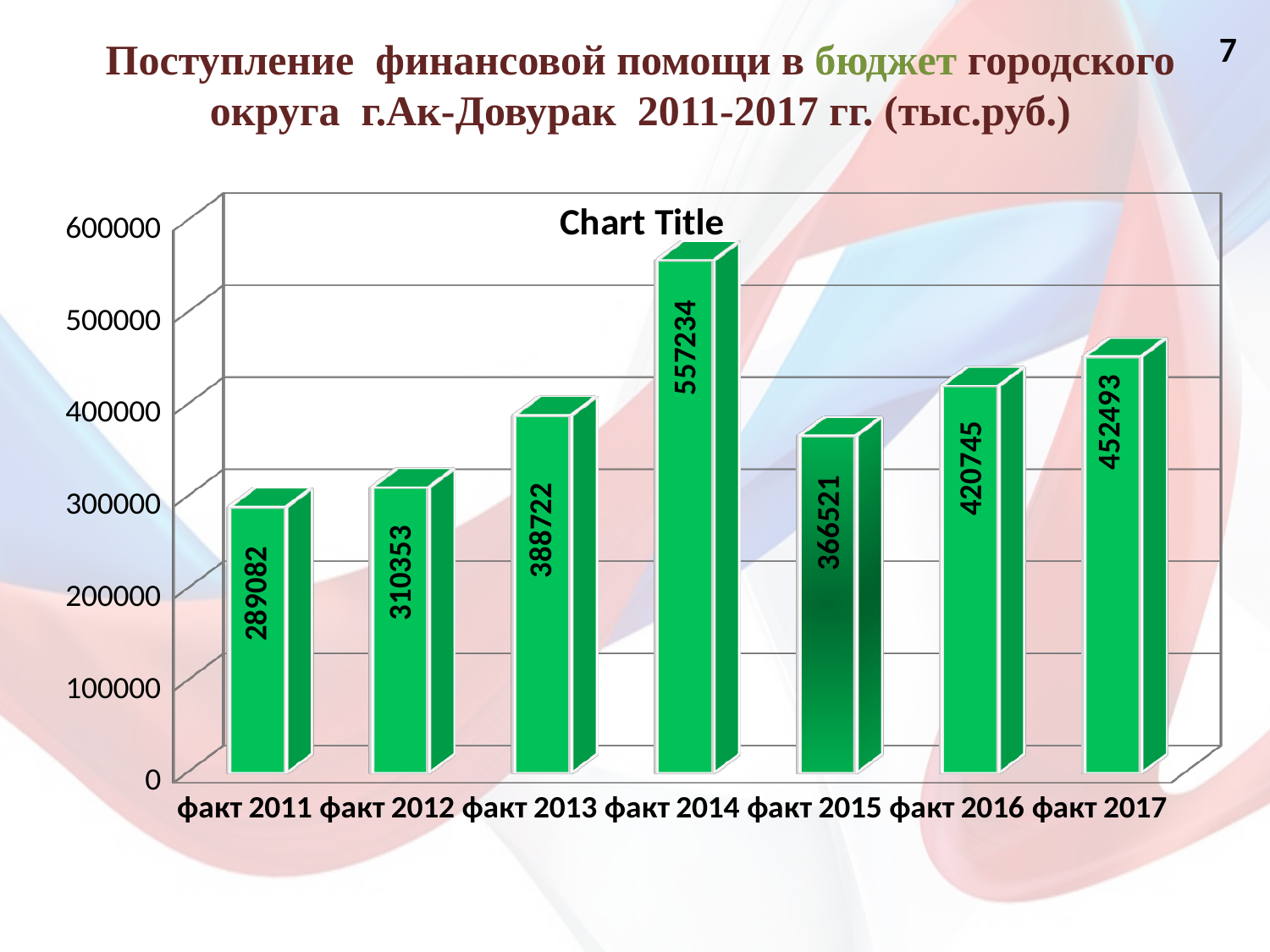
Is the value for факт 2016 greater or less than 400000? greater What is the value for факт 2011? 289082 Which is larger, the value for факт 2013 or the value for факт 2015? факт 2013 What kind of chart is shown on the slide? bar chart Does the value rise or fall from факт 2014 to факт 2015? fall What is the difference between the values for факт 2014 and факт 2015? 190713 What is the value for факт 2016? 420745 What is the difference between the values for факт 2017 and факт 2016? 31748 Which category has the highest value? факт 2014 How many categories are shown on the x axis? 7 What is the value for факт 2014? 557234 Which category has the lowest value? факт 2011